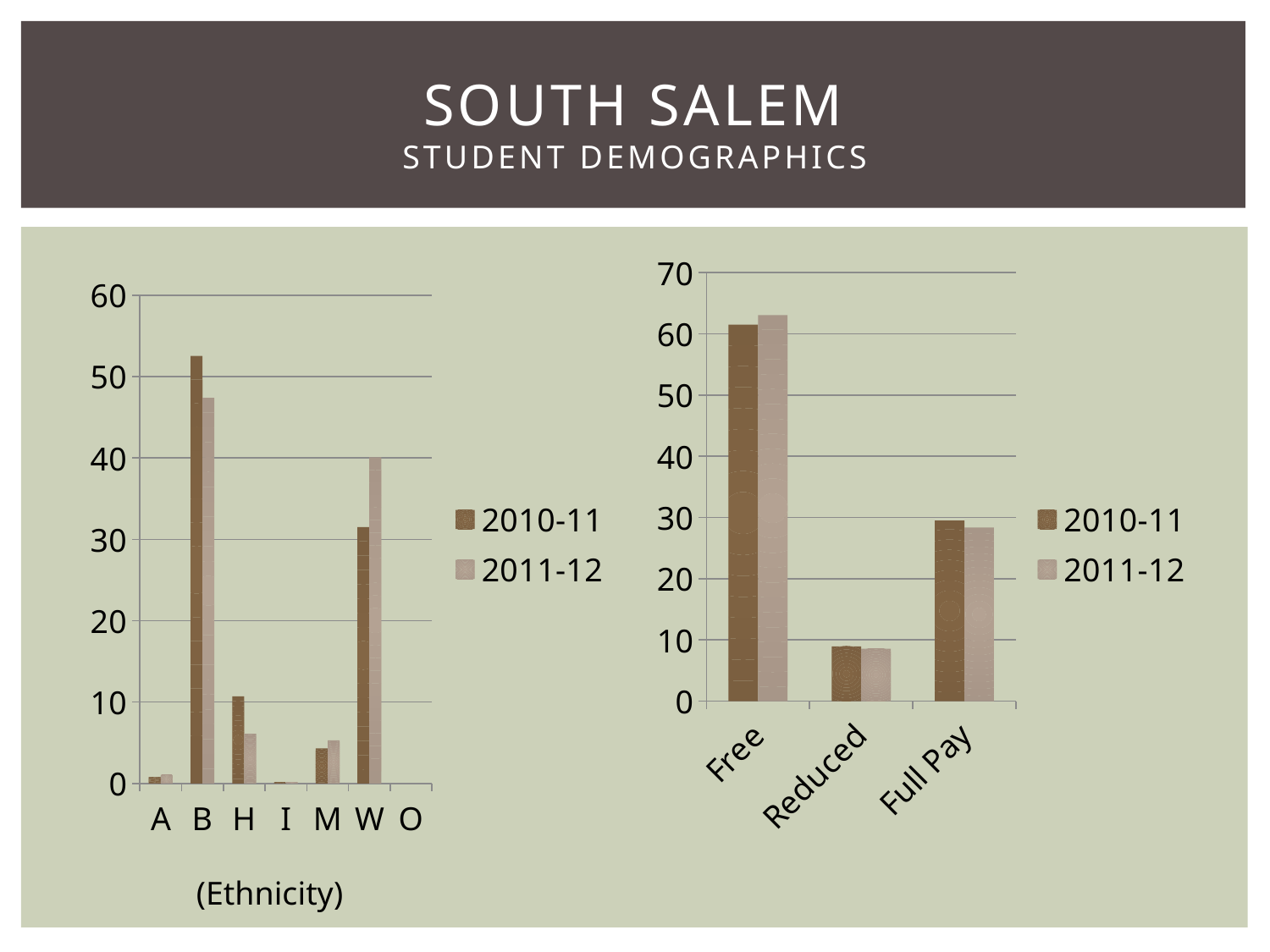
In the right chart (Free, Reduced, Full Pay), is the 2011-12 value for Free greater or less than 60? greater In the left chart labelled (Ethnicity), which is larger for W: the 2010-11 value or the 2011-12 value? 2011-12 In the left chart labelled (Ethnicity), how many categories are shown on the x axis? 7 What kind of chart is the left chart labelled (Ethnicity)? bar chart In the right chart (Free, Reduced, Full Pay), which category has the lowest value for 2010-11? Reduced In the left chart labelled (Ethnicity), how many series does the legend list? 2 In the right chart (Free, Reduced, Full Pay), which category has the highest value for 2011-12? Free In the left chart labelled (Ethnicity), which category has the highest value for 2010-11? B In the left chart labelled (Ethnicity), is the 2011-12 value for W greater or less than 30? greater In the left chart labelled (Ethnicity), which is larger for H: the 2010-11 value or the 2011-12 value? 2010-11 In the left chart labelled (Ethnicity), is the 2010-11 value for B greater or less than 50? greater What are the two legend entries in the right chart (Free, Reduced, Full Pay)? 2010-11 and 2011-12